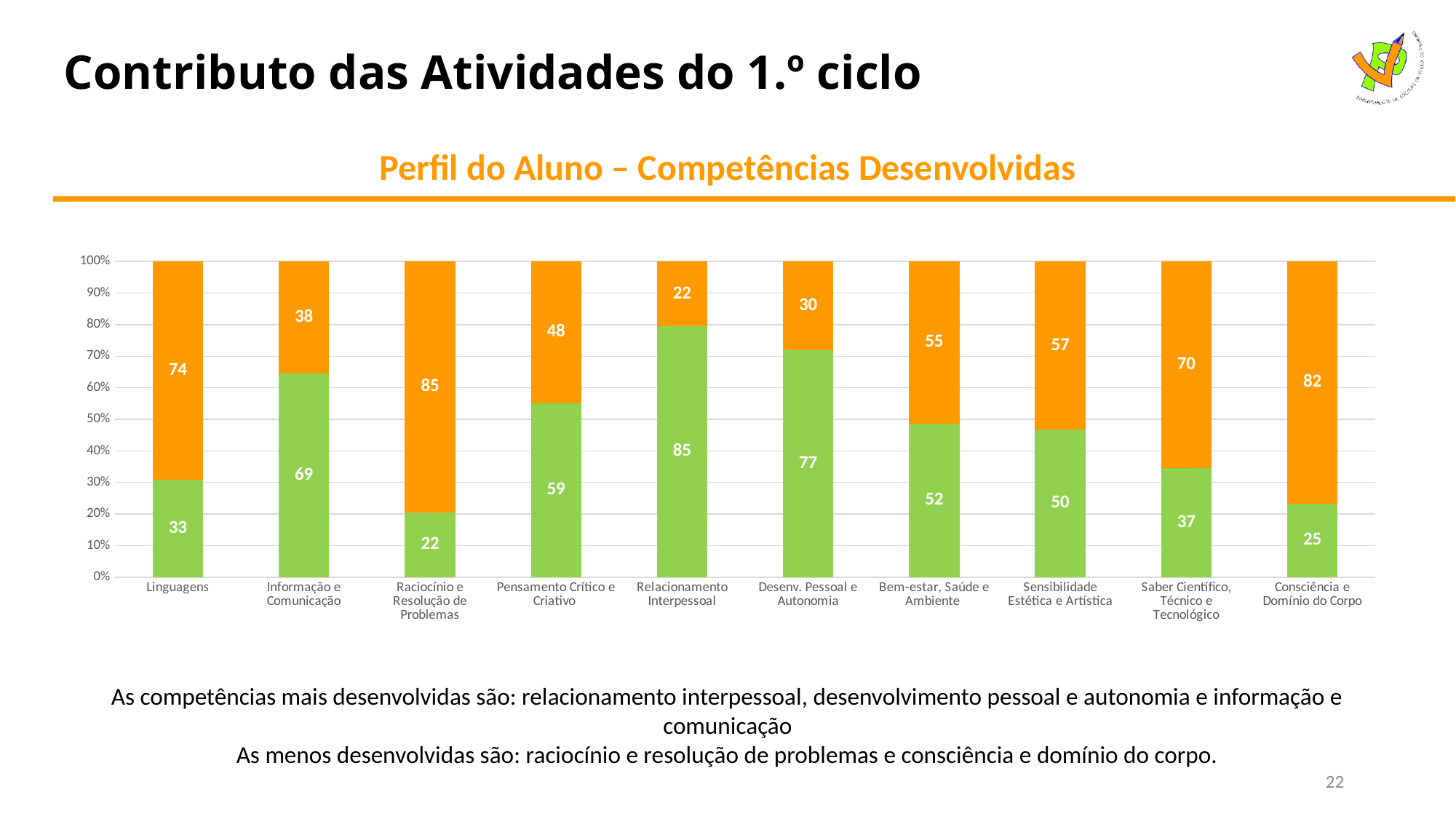
Which category has the lowest green segment value? Raciocínio e Resolução de Problemas What is the value of the orange segment for Consciência e Domínio do Corpo? 82 What is the value of the green segment for Relacionamento Interpessoal? 85 What is the difference between the green and orange segment values for Linguagens? 41 What is the value of the green segment for Raciocínio e Resolução de Problemas? 22 What type of chart is shown on the slide? Stacked bar chart What is the title of the chart? Perfil do Aluno – Competências Desenvolvidas Which is larger for Informação e Comunicação: the green segment or the orange segment? The green segment Which category has the highest green segment value? Relacionamento Interpessoal What is the total of the green and orange segment values for Saber Científico, Técnico e Tecnológico? 107 Which category has the highest orange segment value? Raciocínio e Resolução de Problemas How many categories are shown along the x axis of the chart? 10